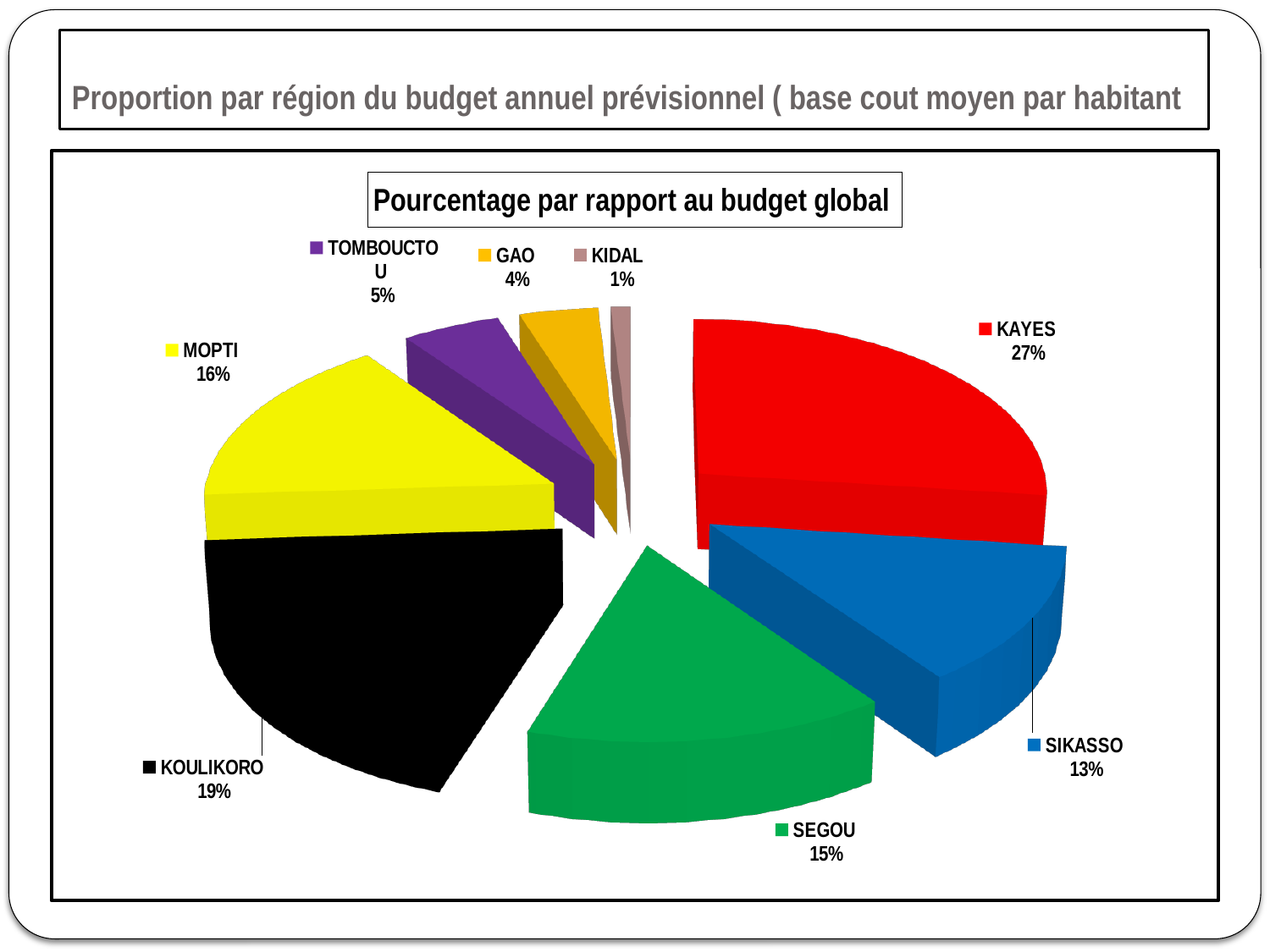
Which has a larger share, MOPTI or SEGOU? MOPTI What is the difference in percentage points between KAYES and SIKASSO? 14 Which region has the largest share of the budget? KAYES What colour is the slice for TOMBOUCTOU? purple How many regions are shown in the pie chart? 8 What percentage of the budget does KIDAL represent? 1% What kind of chart is shown on the slide? pie chart What percentage of the budget does KAYES represent? 27% What percentage of the budget does SEGOU represent? 15% What is the chart's title? Pourcentage par rapport au budget global Which region has the smallest share of the budget? KIDAL What percentage of the budget does KOULIKORO represent? 19%